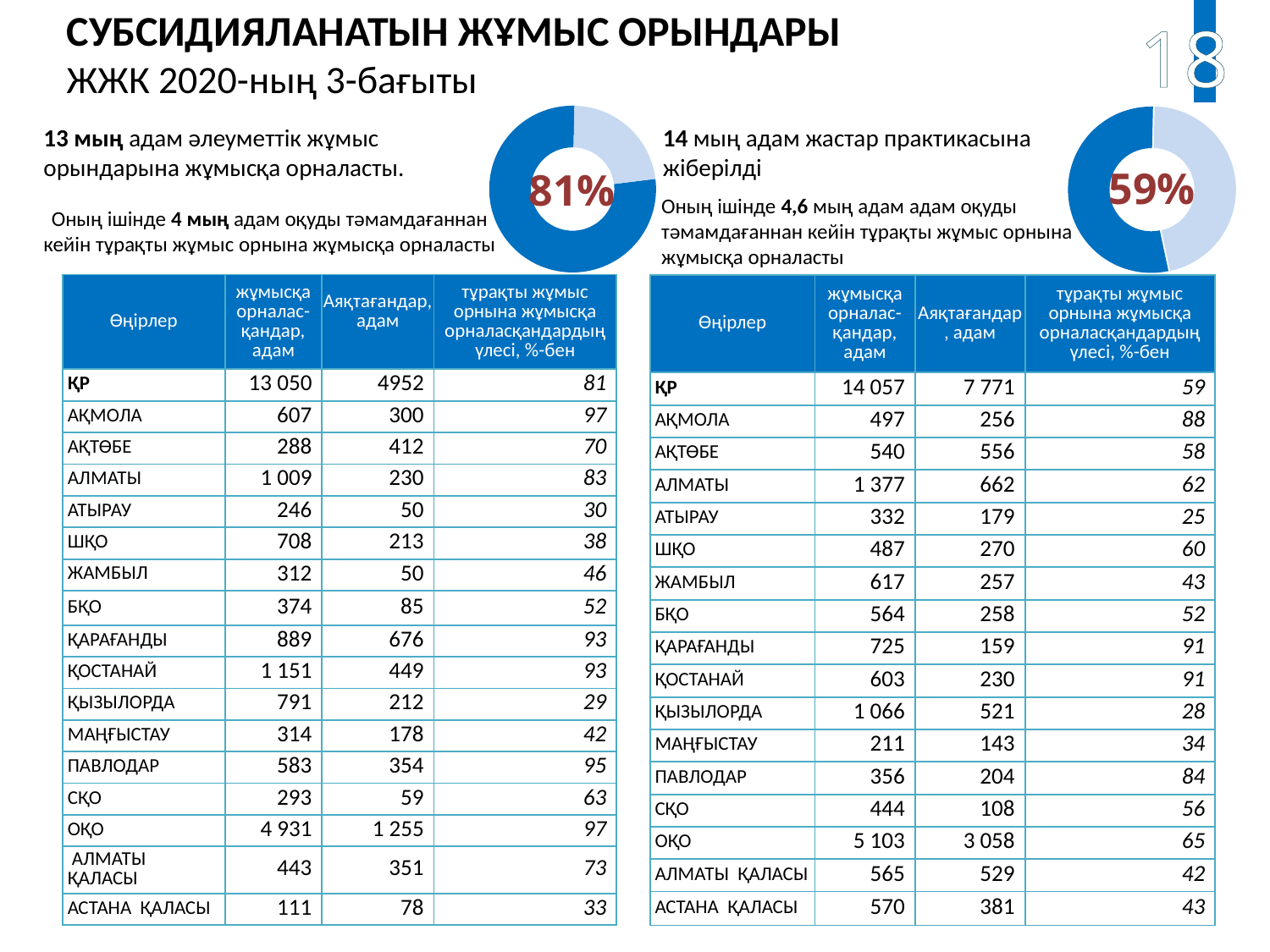
Is the value shown in the left doughnut chart greater or less than 50%? greater How many segments does the right doughnut chart have? 2 What kind of chart is the chart on the right side of the slide, next to the text about 14 thousand people? Doughnut (pie) chart What is the difference between the percentage shown in the left doughnut chart and the percentage shown in the right doughnut chart? 22 percentage points What percentage is printed in the centre of the right doughnut chart? 59% What colour is the larger segment in the right doughnut chart? Dark blue How many segments does the left doughnut chart have? 2 Which doughnut chart shows the larger percentage, the left one or the right one? The left one (81%) Is the value shown in the right doughnut chart greater or less than 75%? less What kind of chart is the chart on the left side of the slide, next to the text about 13 thousand people? Doughnut (pie) chart What percentage is printed in the centre of the left doughnut chart? 81%